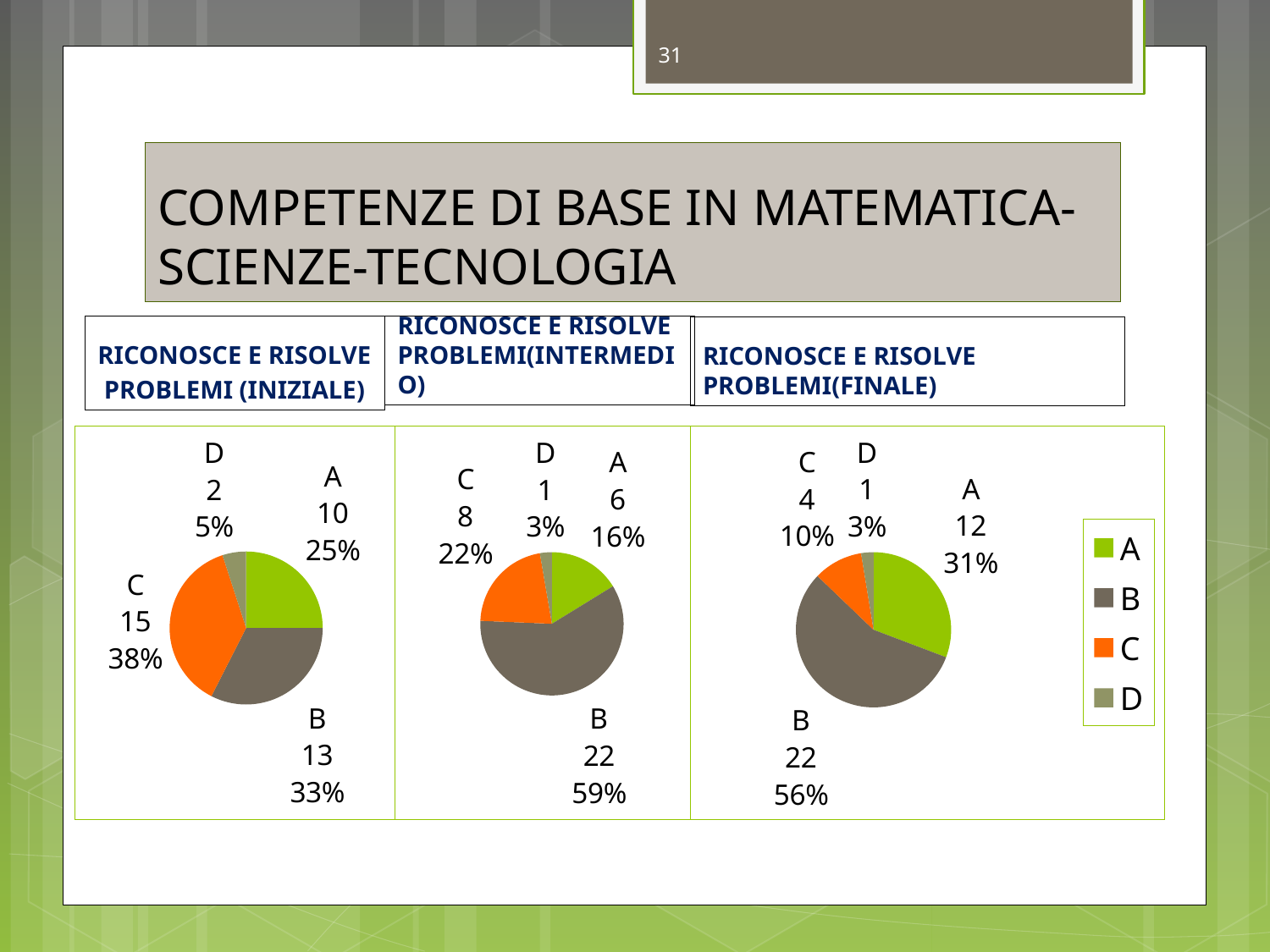
In the left pie chart (INIZIALE), which category has the smallest value? D In the middle pie chart (INTERMEDIO), what percentage share does category C have? 22% In the right pie chart (FINALE), what is the value for category A? 12 In the middle pie chart (INTERMEDIO), what is the difference between the values for B and A? 16 What type of chart is used on this slide? Pie chart In the left pie chart (INIZIALE), which category has the largest value? C In the right pie chart (FINALE), which is larger, the value for A or the value for C? A In the right pie chart (FINALE), what percentage share does category B have? 56% How many categories does the legend list? 4 In the middle pie chart (INTERMEDIO), what is the value for category B? 22 In the left pie chart (INIZIALE), what percentage share does category A have? 25% In the left pie chart (INIZIALE), what is the value for category C? 15